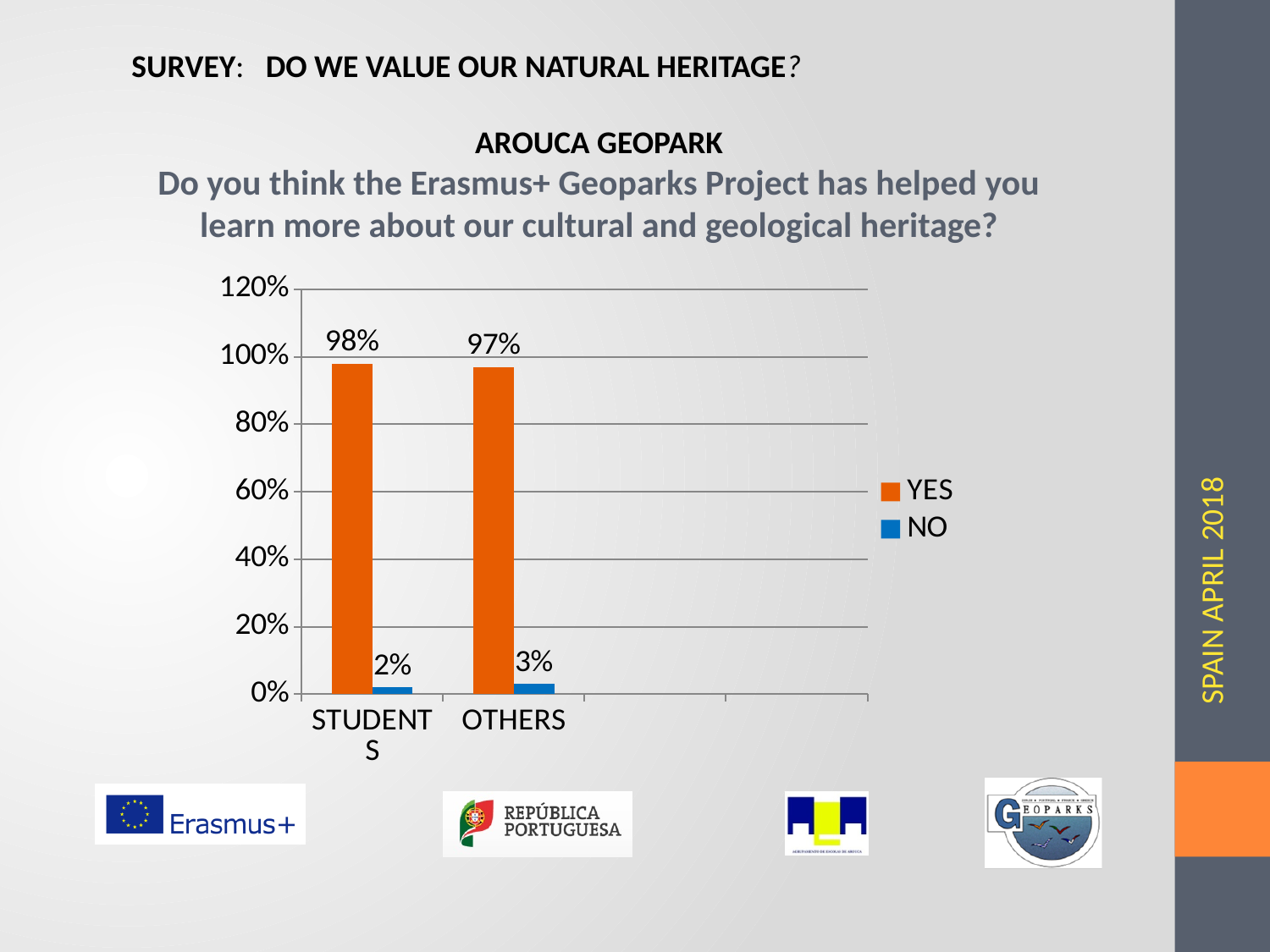
Is the YES value for others greater or less than 80%? greater Which colour represents the YES answers in the chart? Orange What percentage of students answered NO? 2% What percentage of others answered YES? 97% What percentage of students answered YES? 98% How many groups are shown on the x axis? 2 What is the difference between the YES and NO percentages for students? 96% How many series does the legend list? 2 What percentage of others answered NO? 3% Which group has the higher YES percentage, students or others? Students What is the difference between the YES percentages for students and others? 1% What kind of chart is shown on the slide? Bar chart